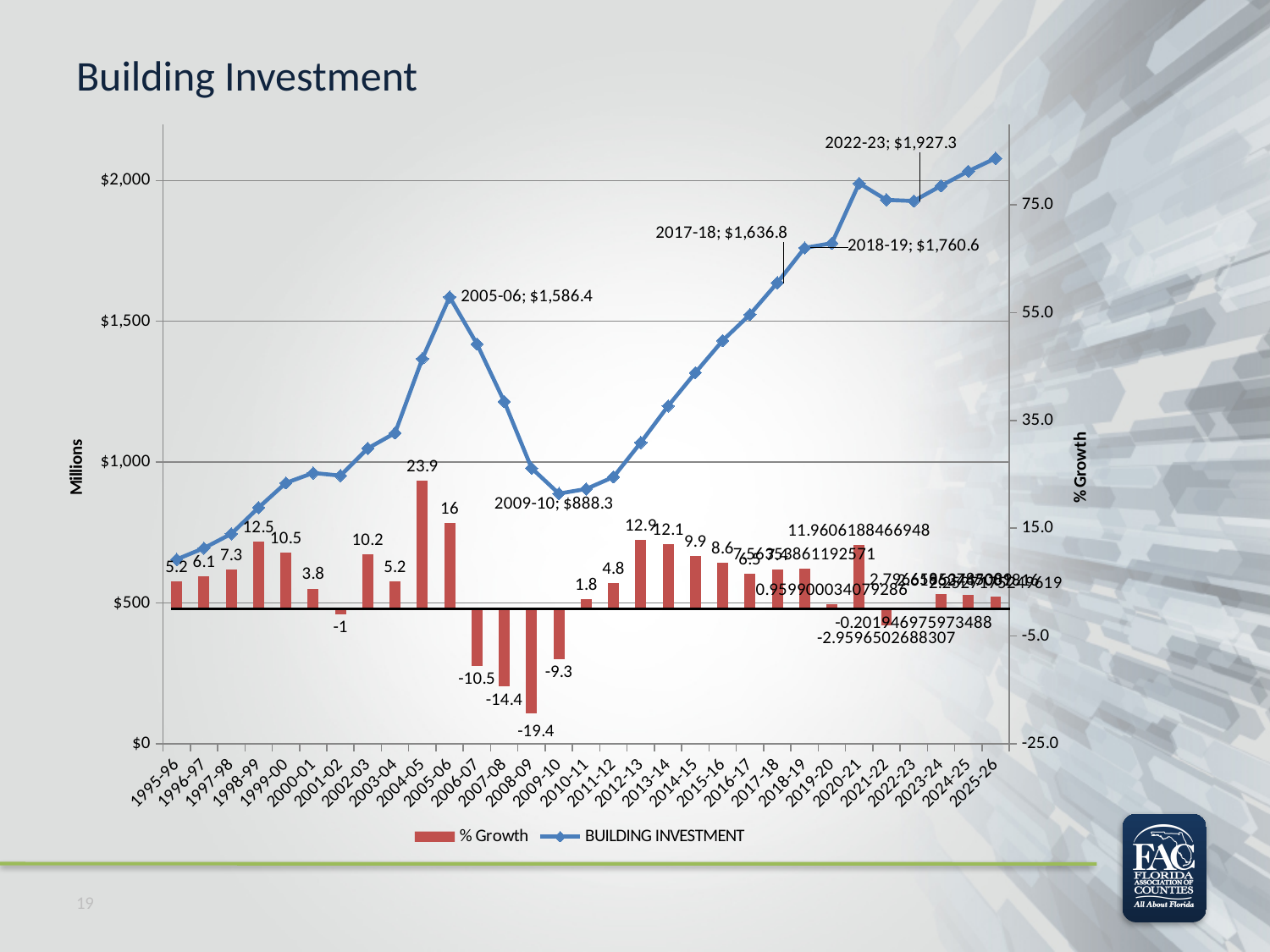
How many series does the legend list? 2 What kind of chart is shown on the slide? A combination chart with bars and a line Is the building investment value for 2025-26 greater or less than $2,000? greater What is the % Growth value for 2004-05? 23.9 What is the building investment value labelled for 2005-06? $1,586.4 What is the building investment value labelled for 2022-23? $1,927.3 What is the % Growth value for 2008-09? -19.4 What is the building investment value labelled for 2009-10? $888.3 What is the difference between the building investment values labelled for 2018-19 and 2017-18? $123.8 Which year has the highest % Growth bar? 2004-05 What are the two series named in the legend? % Growth and BUILDING INVESTMENT Which year has the lowest % Growth bar? 2008-09